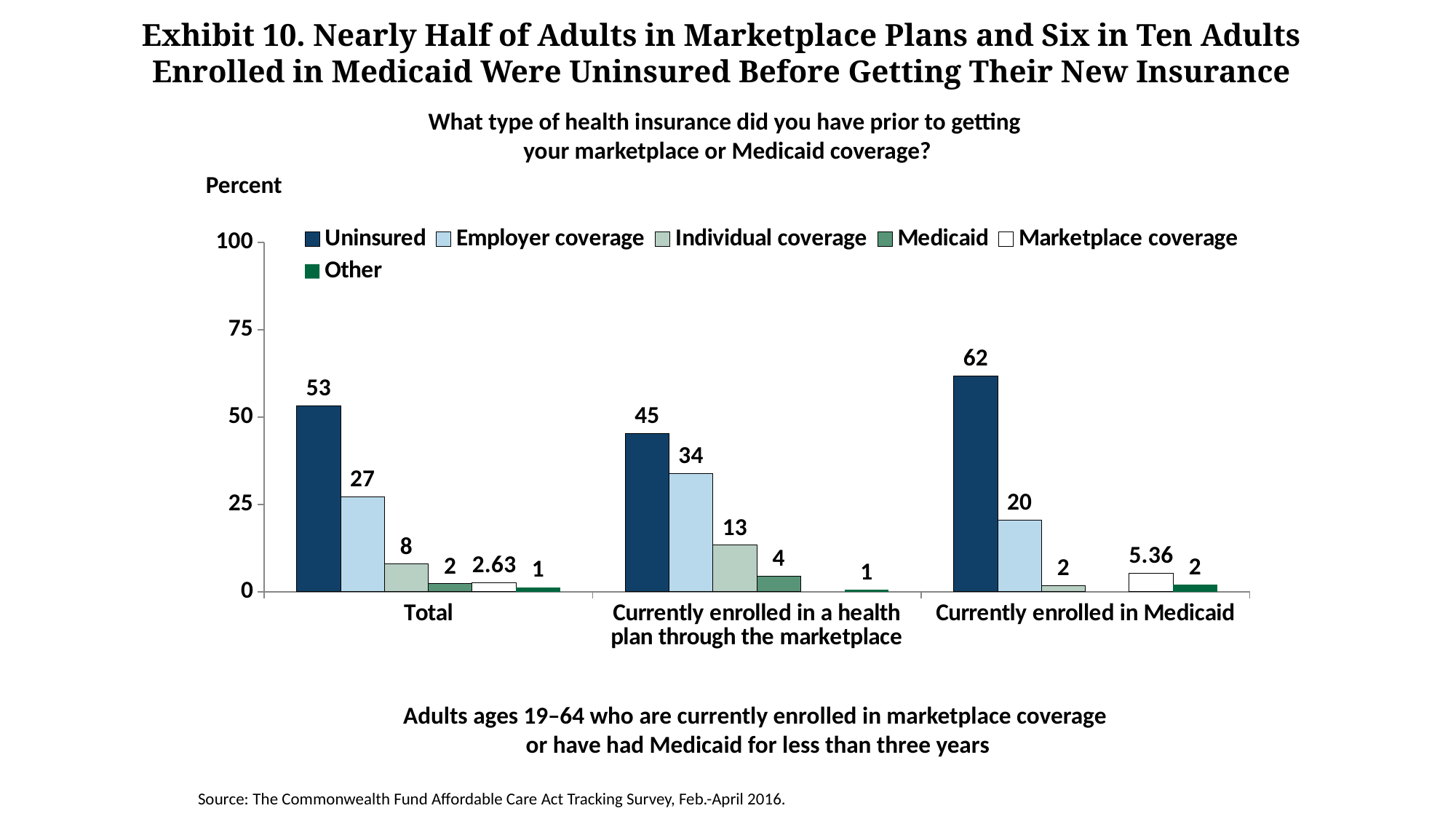
What is the value for Individual coverage in the Total group? 8 Which group has the lowest value for Employer coverage? Currently enrolled in Medicaid What percent of adults currently enrolled in Medicaid were uninsured before getting their new insurance? 62 How many groups are shown on the x axis? 3 What is the value for Marketplace coverage among adults currently enrolled in Medicaid? 5.36 What is the difference between the Uninsured values for adults enrolled in Medicaid and adults enrolled in a marketplace plan? 17 Is the Uninsured value for the Total group greater or less than 50? greater How many series does the legend list? 6 Is the Employer coverage value larger for the Total group or for adults currently enrolled in a marketplace plan? Currently enrolled in a health plan through the marketplace What kind of chart is shown on the slide? Bar chart What is the value for Employer coverage among adults currently enrolled in a health plan through the marketplace? 34 Which group has the highest value for Uninsured? Currently enrolled in Medicaid